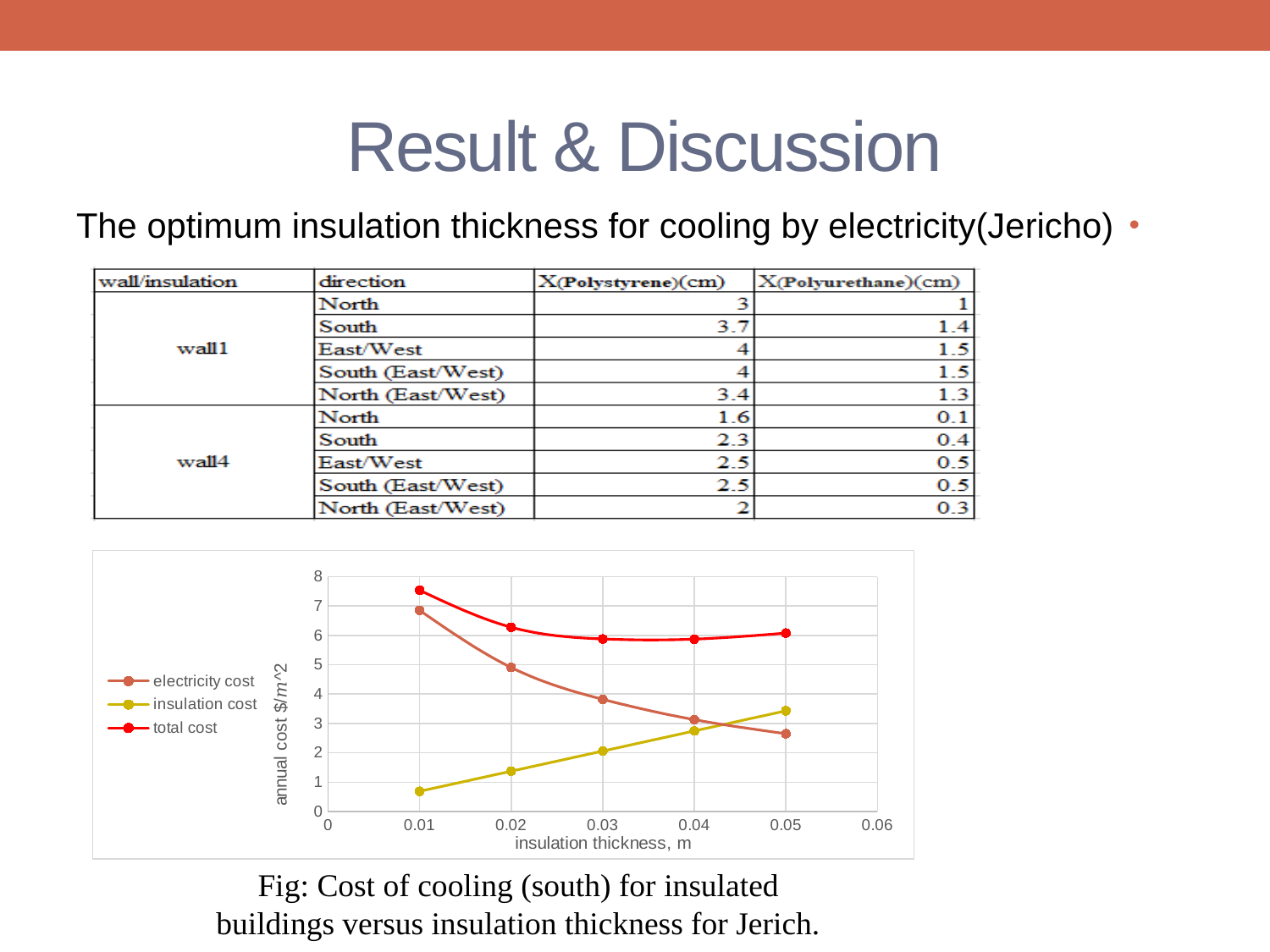
Which series has the highest value at an insulation thickness of 0.03 m? total cost Is the total cost at an insulation thickness of 0.01 m greater or less than 7? greater How many data points are plotted for the total cost series? 5 Is the electricity cost at an insulation thickness of 0.05 m greater or less than 3? less Does the insulation cost rise or fall as insulation thickness increases? rise At an insulation thickness of 0.05 m, which is larger: the electricity cost or the insulation cost? insulation cost How many series does the chart legend list? 3 What is the label on the x axis of the chart? insulation thickness, m Is the insulation cost at an insulation thickness of 0.01 m greater or less than 1? less What kind of chart is shown on the slide? line chart Does the electricity cost rise or fall as insulation thickness increases? fall